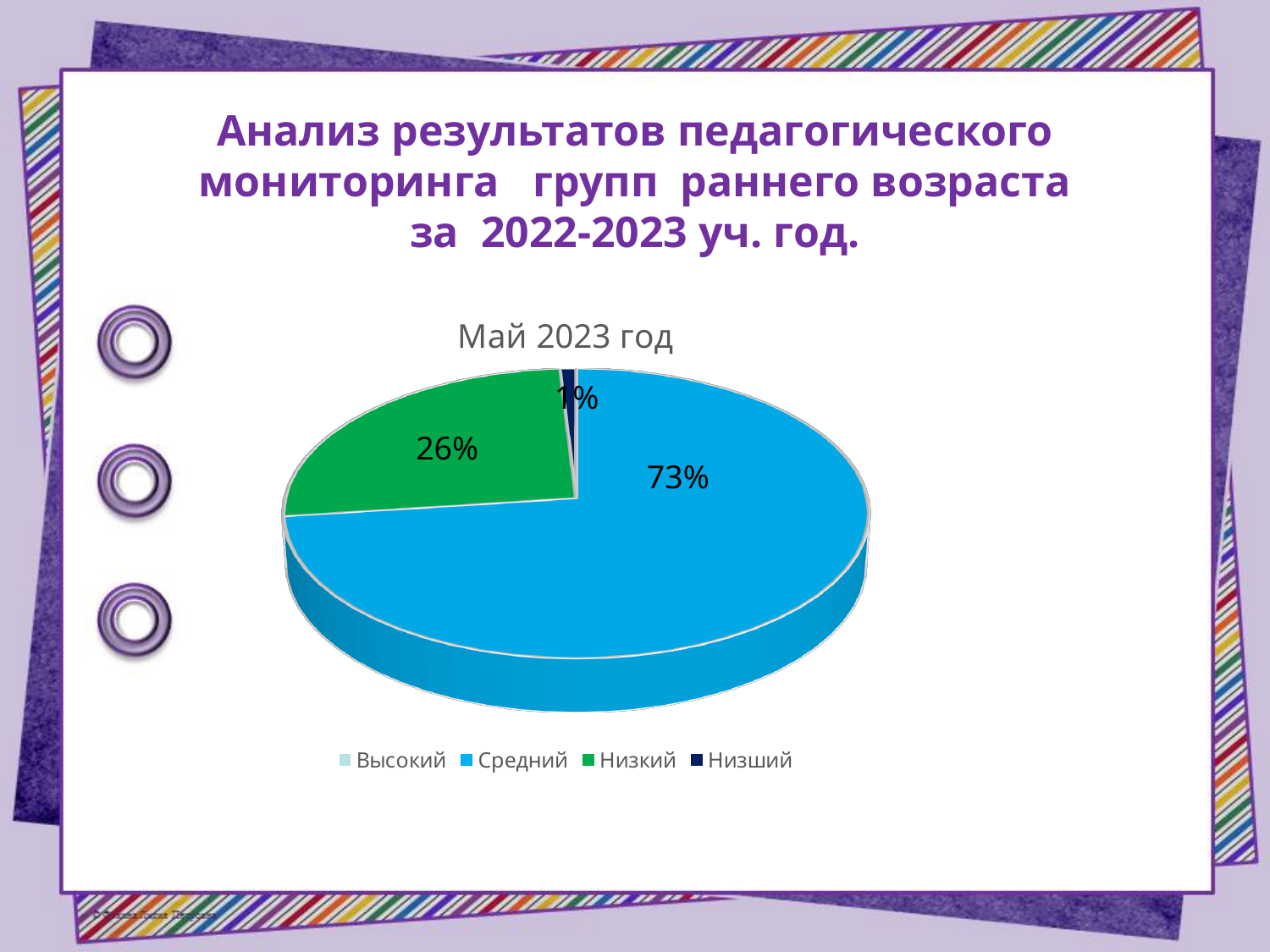
What is the title of the chart? Май 2023 год What kind of chart is shown on the slide? pie chart What is the combined share of the Низкий and Низший slices? 27% What colour is the Низкий slice? green How many entries does the legend list? 4 Which is larger, the Низкий share or the Низший share? Низкий What percentage does the Средний slice show? 73% What percentage does the Низший slice show? 1% Which labelled slice has the smallest share of the pie? Низший What percentage does the Низкий slice show? 26% What is the difference between the Средний and Низкий shares? 47% Which category has the largest share of the pie? Средний